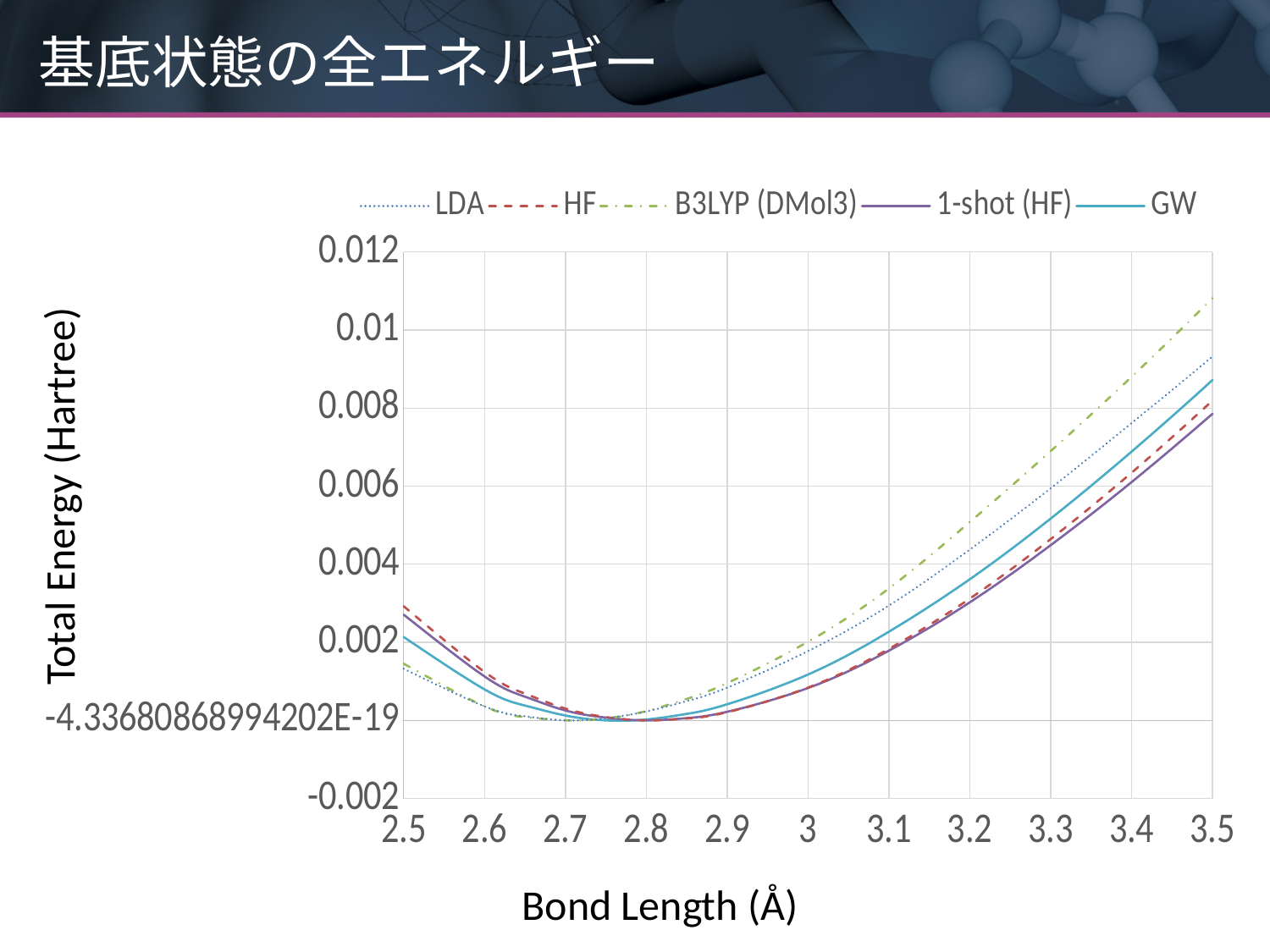
How many series does the legend list? 5 Is the value for GW at a bond length of 3 greater or less than 0.002? less Is the value for LDA at a bond length of 3.5 greater or less than 0.01? less Which series has the highest value at a bond length of 3.5? B3LYP (DMol3) At a bond length of 3.5, which is larger, the value for LDA or the value for 1-shot (HF)? LDA What is the title of the x axis? Bond Length (Å) Is the value for B3LYP (DMol3) at a bond length of 3.5 greater or less than 0.01? greater What is the title of the y axis? Total Energy (Hartree) Do the values for GW rise or fall as the bond length increases from 2.8 to 3.5? rise What kind of chart is shown on the slide? line chart